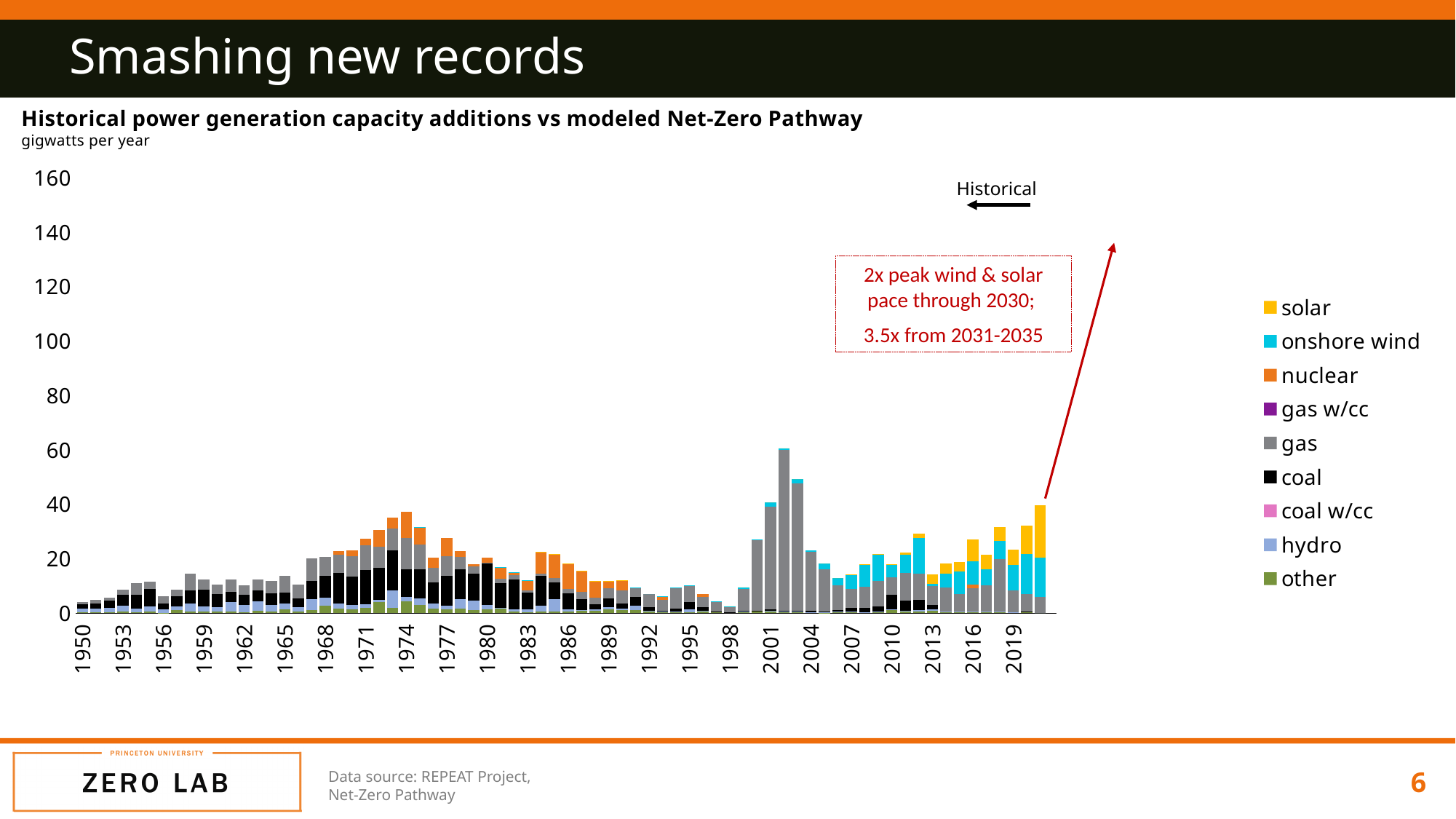
Which year has the larger total capacity addition, 2001 or 1974? 2001 How many series does the legend list? 9 Is the total capacity addition for 1998 greater or less than 20? less What is the title of the chart? Historical power generation capacity additions vs modeled Net-Zero Pathway Is the total capacity addition for 1974 greater or less than 20? greater Is the total capacity addition for 2001 greater or less than 80? less Which year has the tallest bar in the chart? 2002 How many year labels are shown on the x axis? 24 What kind of chart is shown on the slide? stacked bar chart What unit is the y axis measured in, according to the subtitle? gigawatts per year